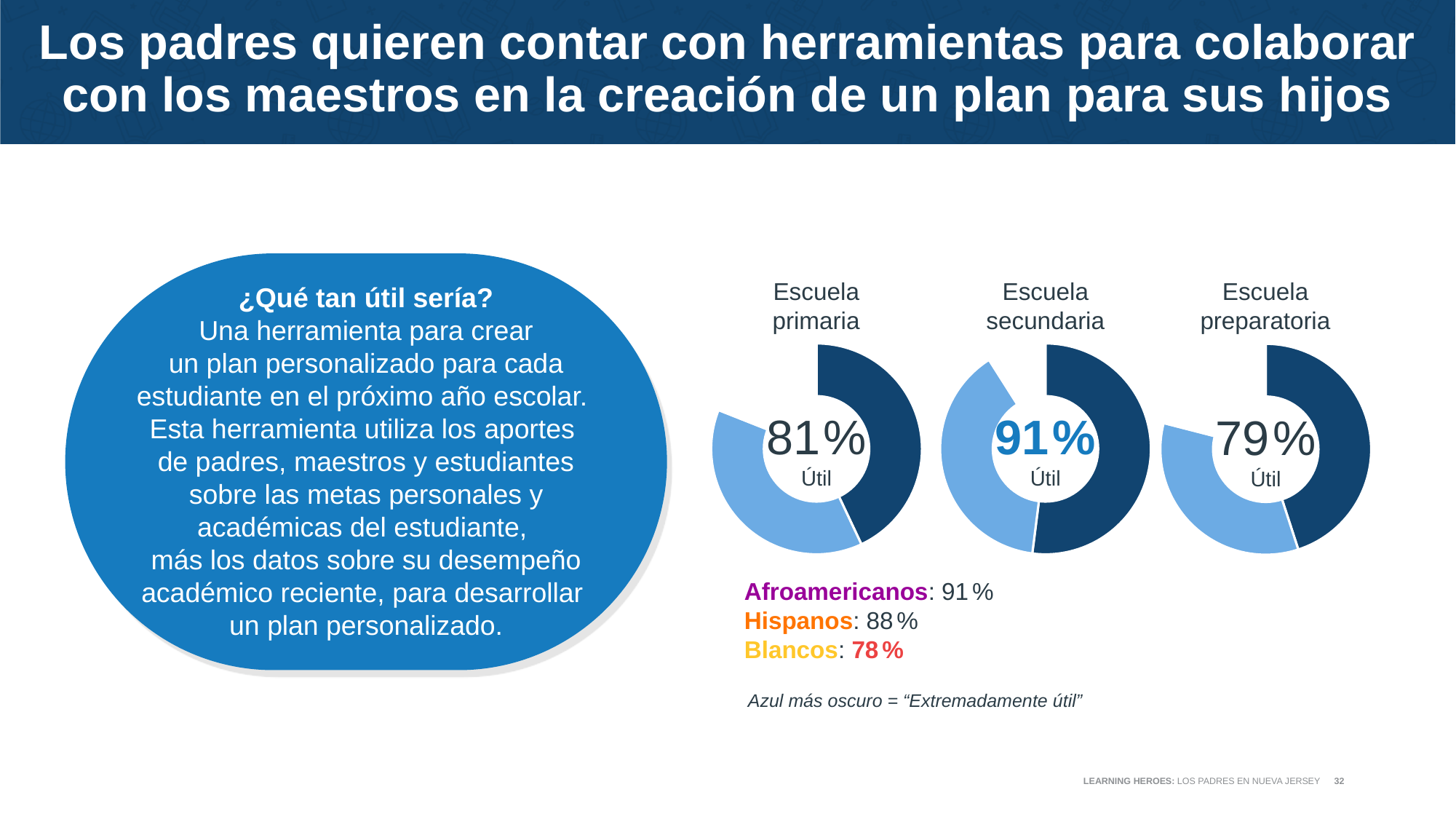
Which school level's percentage is highlighted in blue text in its donut chart? Escuela secundaria Which is larger, the Escuela primaria percentage or the Escuela secundaria percentage? Escuela secundaria What is the difference between the Escuela secundaria and Escuela preparatoria percentages? 12% Which school level has the highest percentage of parents saying the tool would be useful? Escuela secundaria What percentage of parents of Escuela primaria students say the tool would be useful (Útil)? 81% What percentage is shown in the Escuela secundaria donut chart? 91% What is the difference between the Escuela primaria and Escuela preparatoria percentages? 2% How many donut charts are shown on the slide? 3 According to the note below the charts, what does the darker blue segment represent? Extremadamente útil What percentage is shown in the Escuela preparatoria donut chart? 79% Which school level has the lowest percentage of parents saying the tool would be useful? Escuela preparatoria What type of chart is used to show the percentages for each school level? Donut chart